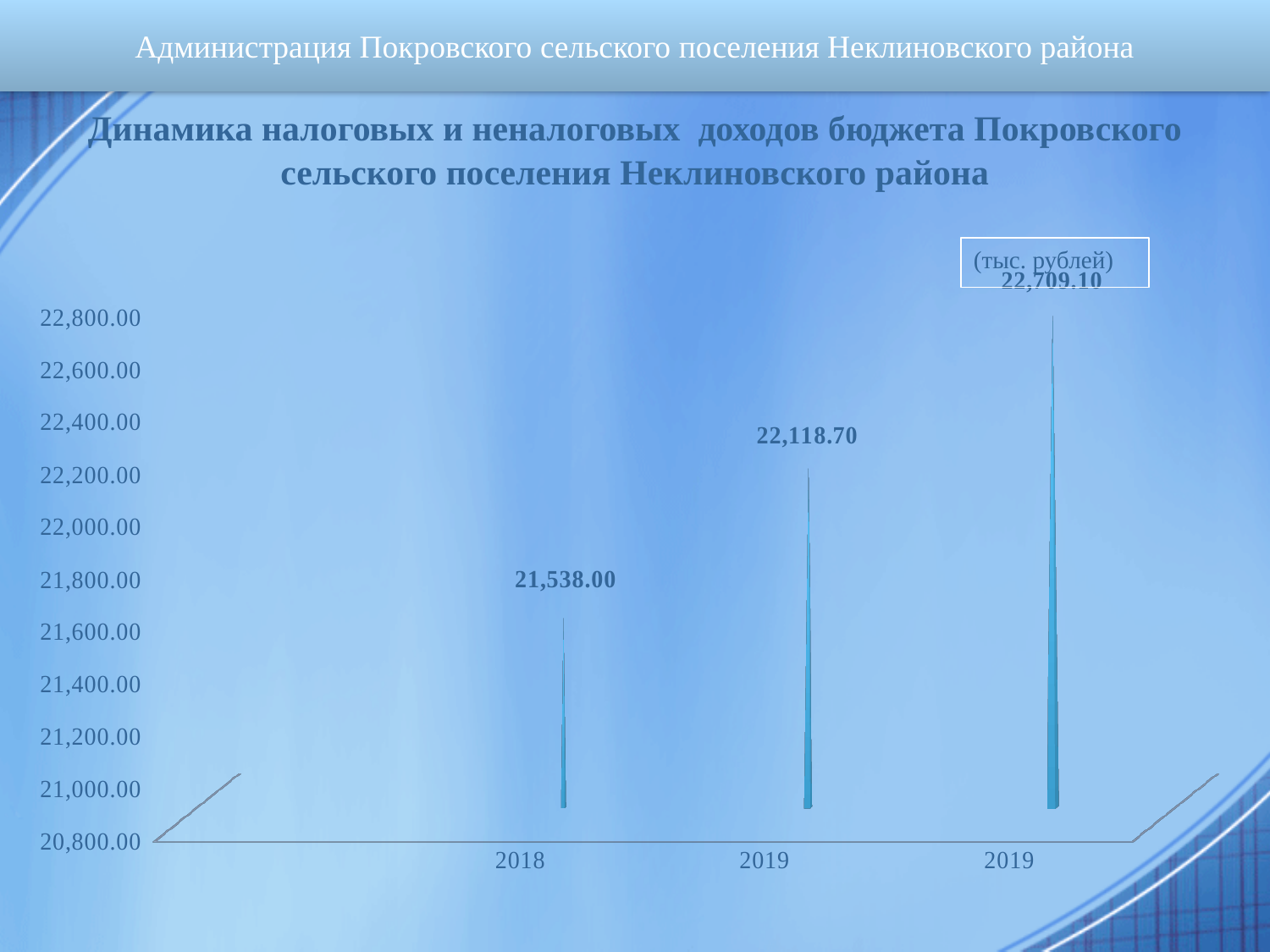
What is the difference between the rightmost bar and the 2018 bar? 1,171.10 What is the difference between the middle bar and the 2018 bar? 580.70 Do the values rise or fall from left to right along the x axis? Rise How many bars are plotted in the chart? 3 Which bar has the lowest value? 2018, 21,538.00 Is the value for 2018 greater or less than 21,600.00? less What is the value of the middle bar (the first one labelled 2019)? 22,118.70 Which bar has the highest value? The rightmost bar (second 2019), 22,709.10 Which is larger: the 2018 bar or the middle bar? The middle bar (22,118.70) What is the value of the rightmost bar (the second one labelled 2019)? 22,709.10 What is the value of the bar for 2018? 21,538.00 What kind of chart is shown on the slide? Bar chart